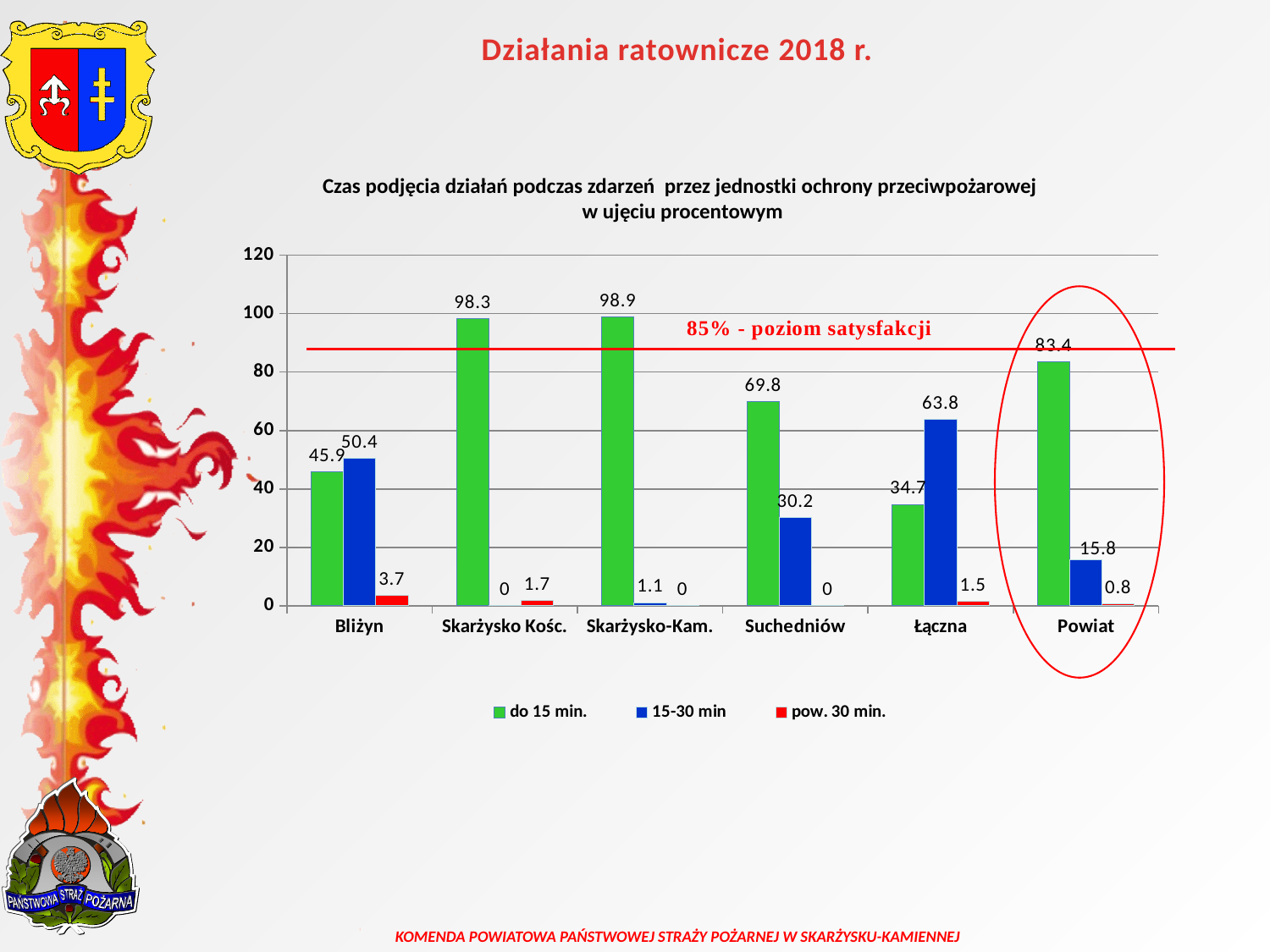
Which category has the highest value in the 'do 15 min.' series? Skarżysko-Kam. How many categories are shown on the x axis? 6 What is the value of the 'pow. 30 min.' series for Bliżyn? 3.7 What label is written on the red horizontal reference line in the chart? 85% - poziom satysfakcji What is the value of the 'do 15 min.' series for Powiat? 83.4 Which category has the lowest value in the 'do 15 min.' series? Łączna Which category has the highest value in the '15-30 min' series? Łączna What is the value of the '15-30 min' series for Łączna? 63.8 For Bliżyn, which is larger: the 'do 15 min.' value or the '15-30 min' value? 15-30 min What is the difference between the 'do 15 min.' and '15-30 min' values for Suchedniów? 39.6 What kind of chart is shown on the slide? bar chart How many series does the legend list? 3